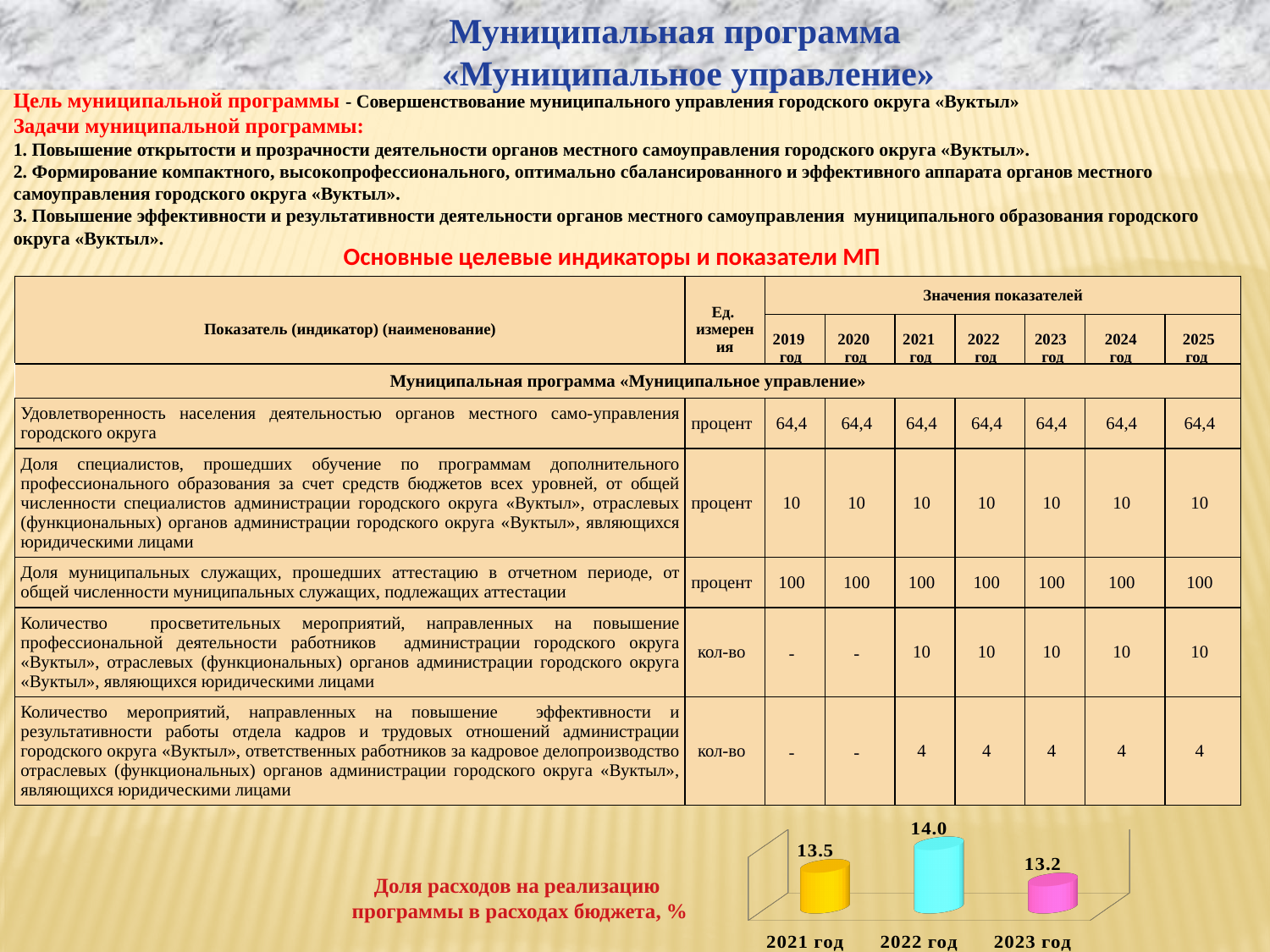
What kind of chart is shown at the bottom of the slide? bar chart What is the difference between the values for 2021 год and 2023 год? 0.3 How many years are shown in the chart? 3 Which year has the lowest value in the chart? 2023 год Which is larger, the value for 2021 год or the value for 2022 год? 2022 год Does the value rise or fall from 2022 год to 2023 год? fall What does the chart at the bottom of the slide show, according to its caption? Доля расходов на реализацию программы в расходах бюджета, % What is the value for 2022 год in the chart? 14.0 What is the value for 2021 год in the chart? 13.5 What is the value for 2023 год in the chart? 13.2 What is the difference between the values for 2022 год and 2023 год? 0.8 Which year has the highest value in the chart? 2022 год